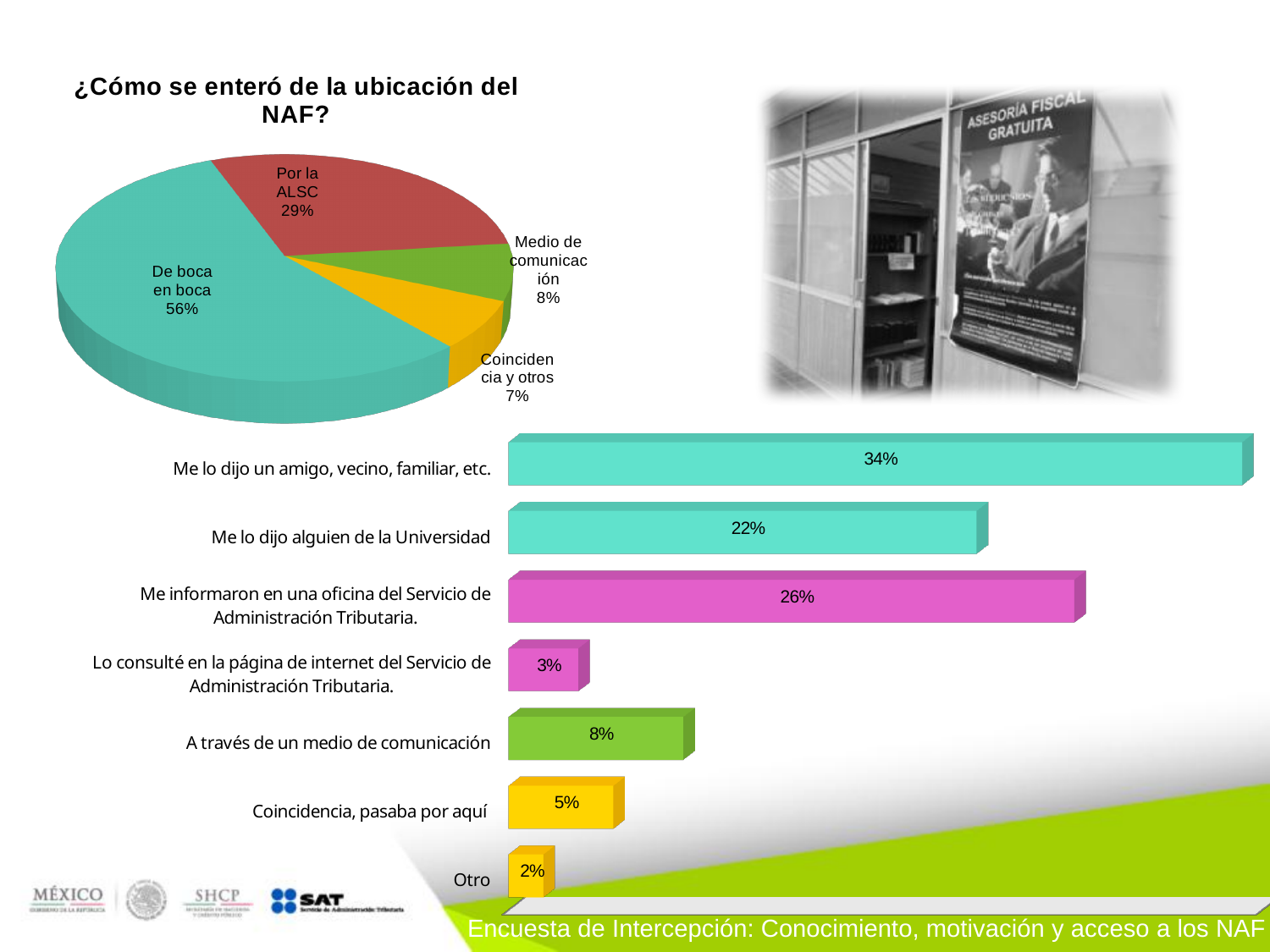
In the pie chart titled '¿Cómo se enteró de la ubicación del NAF?', which slice is the smallest? Coincidencia y otros In the pie chart titled '¿Cómo se enteró de la ubicación del NAF?', what is the difference between 'De boca en boca' and 'Por la ALSC'? 27% In the pie chart titled '¿Cómo se enteró de la ubicación del NAF?', what share is 'De boca en boca'? 56% In the bar chart at the bottom of the slide, which category has the lowest value? Otro In the bar chart at the bottom of the slide, how many categories are shown? 7 What kind of chart is the chart at the bottom of the slide? Bar chart In the bar chart at the bottom of the slide, which category has the highest value? Me lo dijo un amigo, vecino, familiar, etc. In the bar chart at the bottom of the slide, what is the value for 'Me informaron en una oficina del Servicio de Administración Tributaria.'? 26% In the bar chart at the bottom of the slide, which is larger: 'A través de un medio de comunicación' or 'Coincidencia, pasaba por aquí'? A través de un medio de comunicación In the pie chart titled '¿Cómo se enteró de la ubicación del NAF?', how many slices are there? 4 In the bar chart at the bottom of the slide, what is the value for 'Me lo dijo alguien de la Universidad'? 22% In the pie chart titled '¿Cómo se enteró de la ubicación del NAF?', what share is 'Por la ALSC'? 29%